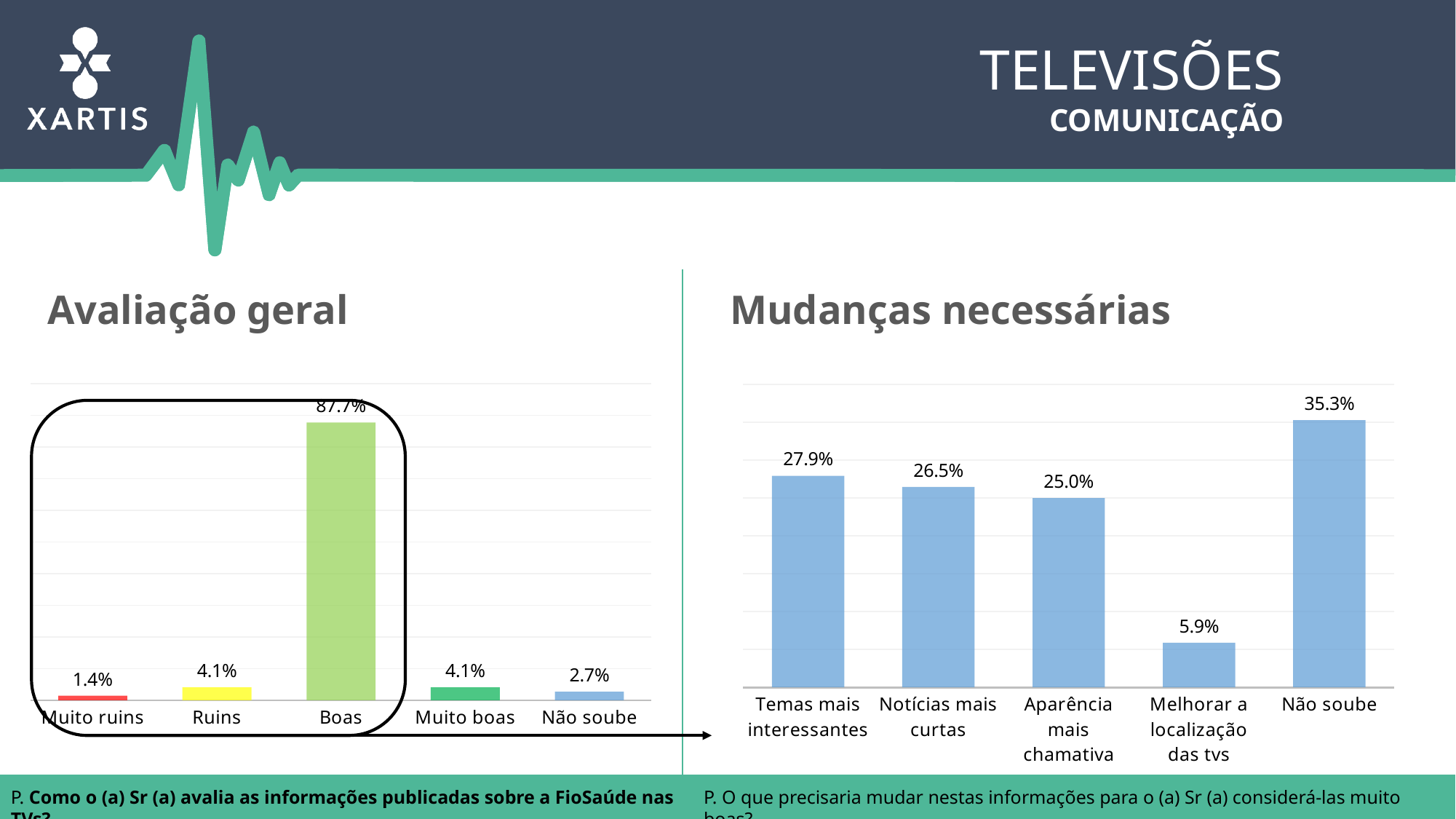
How many categories are shown in the 'Avaliação geral' chart? 5 In the 'Mudanças necessárias' chart, which is larger: Temas mais interessantes or Notícias mais curtas? Temas mais interessantes In the 'Avaliação geral' chart, what is the value for Boas? 87.7% In the 'Mudanças necessárias' chart, which category has the highest value? Não soube What type of chart is the 'Mudanças necessárias' chart? Bar chart In the 'Avaliação geral' chart, what colour is the bar for Boas? Green In the 'Mudanças necessárias' chart, what is the value for Melhorar a localização das tvs? 5.9% In the 'Avaliação geral' chart, what is the value for Muito ruins? 1.4% In the 'Mudanças necessárias' chart, what is the value for Não soube? 35.3% In the 'Avaliação geral' chart, what is the difference between Boas and Muito boas? 83.6% In the 'Mudanças necessárias' chart, what is the difference between Não soube and Aparência mais chamativa? 10.3% In the 'Avaliação geral' chart, which category has the lowest value? Muito ruins